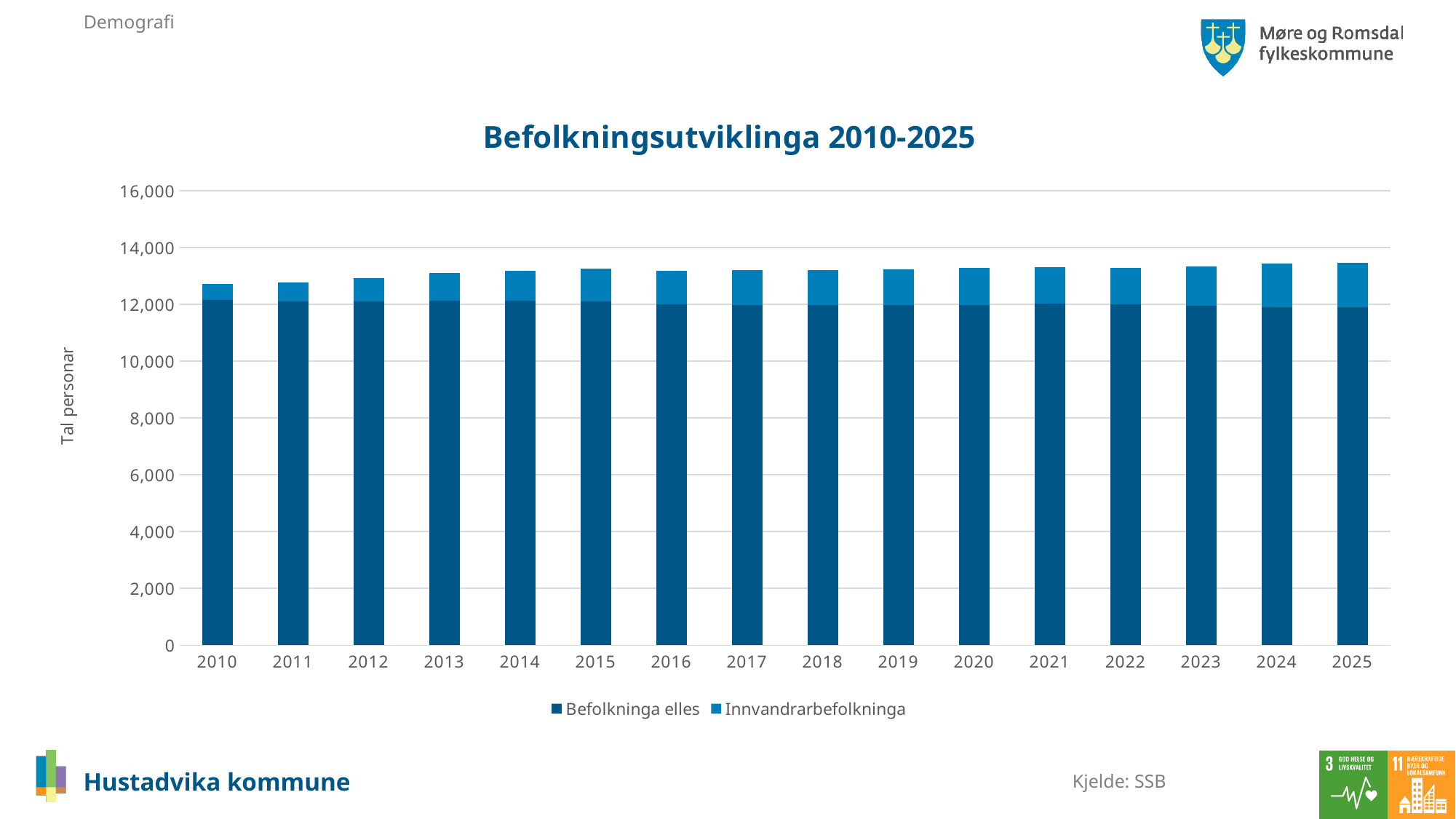
Do the total bar heights generally rise or fall from 2010 to 2025? rise Is the total population bar for 2015 greater or less than 14,000? less What is the label on the y axis of the chart? Tal personar How many series does the legend list? 2 Does the Innvandrarbefolkninga segment generally rise or fall from 2010 to 2025? rise How many years are shown on the x axis of the chart? 16 Is the total population bar for 2025 greater or less than 14,000? less What is the title of the chart? Befolkningsutviklinga 2010-2025 Which year has the larger total bar, 2010 or 2025? 2025 What kind of chart is shown on the slide? Stacked bar chart Is the value for Befolkninga elles in 2020 greater or less than 10,000? greater